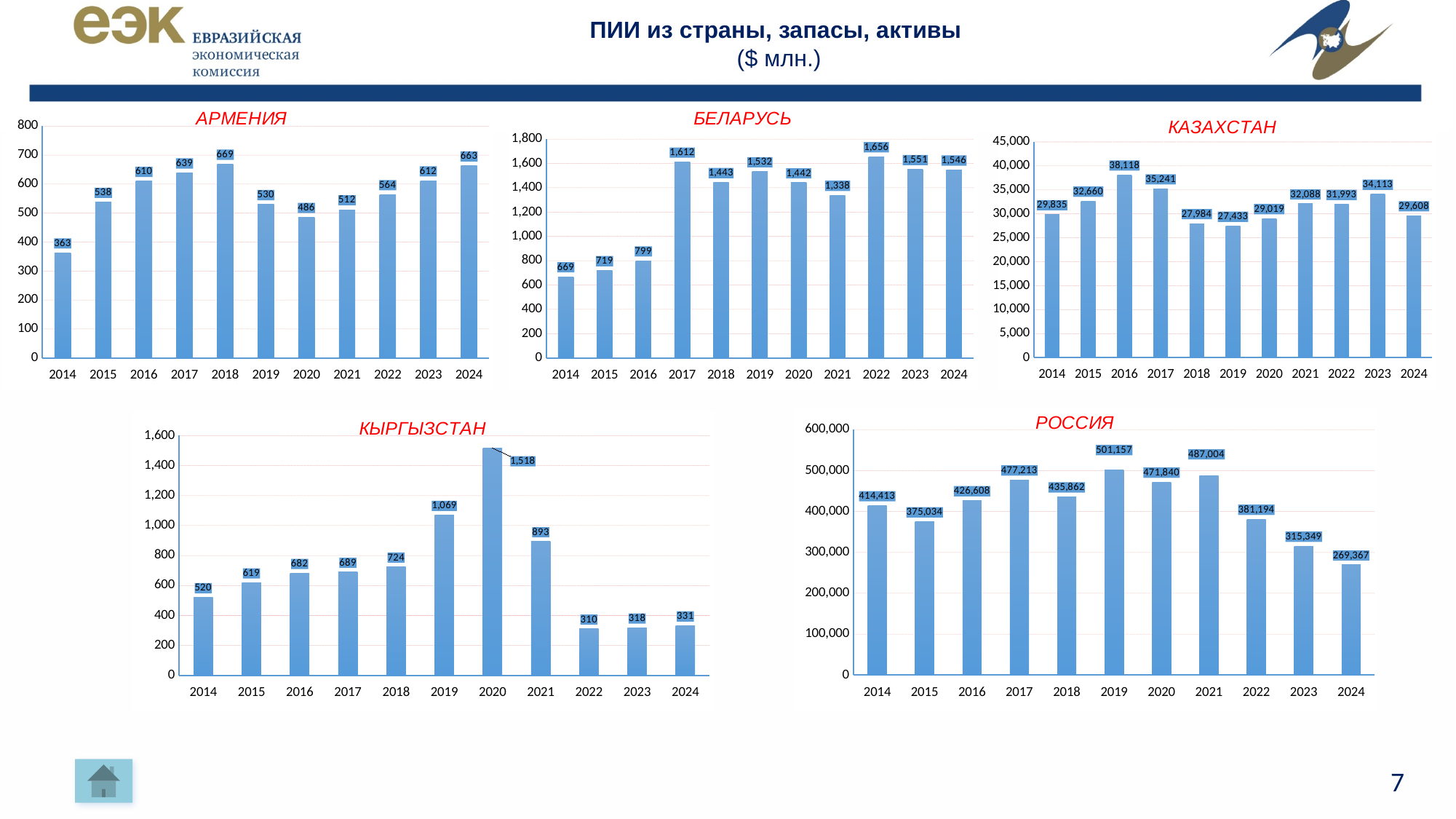
In the РОССИЯ chart, what is the difference between the 2019 value and the 2024 value? 231,790 In the КАЗАХСТАН chart, which year has the highest value? 2016 In the РОССИЯ chart, which is larger, the value for 2017 or the value for 2021? 2021 In the КЫРГЫЗСТАН chart, what is the difference between the 2020 value and the 2019 value? 449 How many years are shown on the x axis of the РОССИЯ chart? 11 In the КАЗАХСТАН chart, what is the value for 2024? 29,608 In the БЕЛАРУСЬ chart, what is the value for 2021? 1,338 In the БЕЛАРУСЬ chart, which year has the highest value? 2022 In the КЫРГЫЗСТАН chart, which year has the lowest value? 2022 In the АРМЕНИЯ chart, which year has the lowest value? 2014 What type of chart is used for КЫРГЫЗСТАН? Bar chart In the АРМЕНИЯ chart, what is the value for 2018? 669